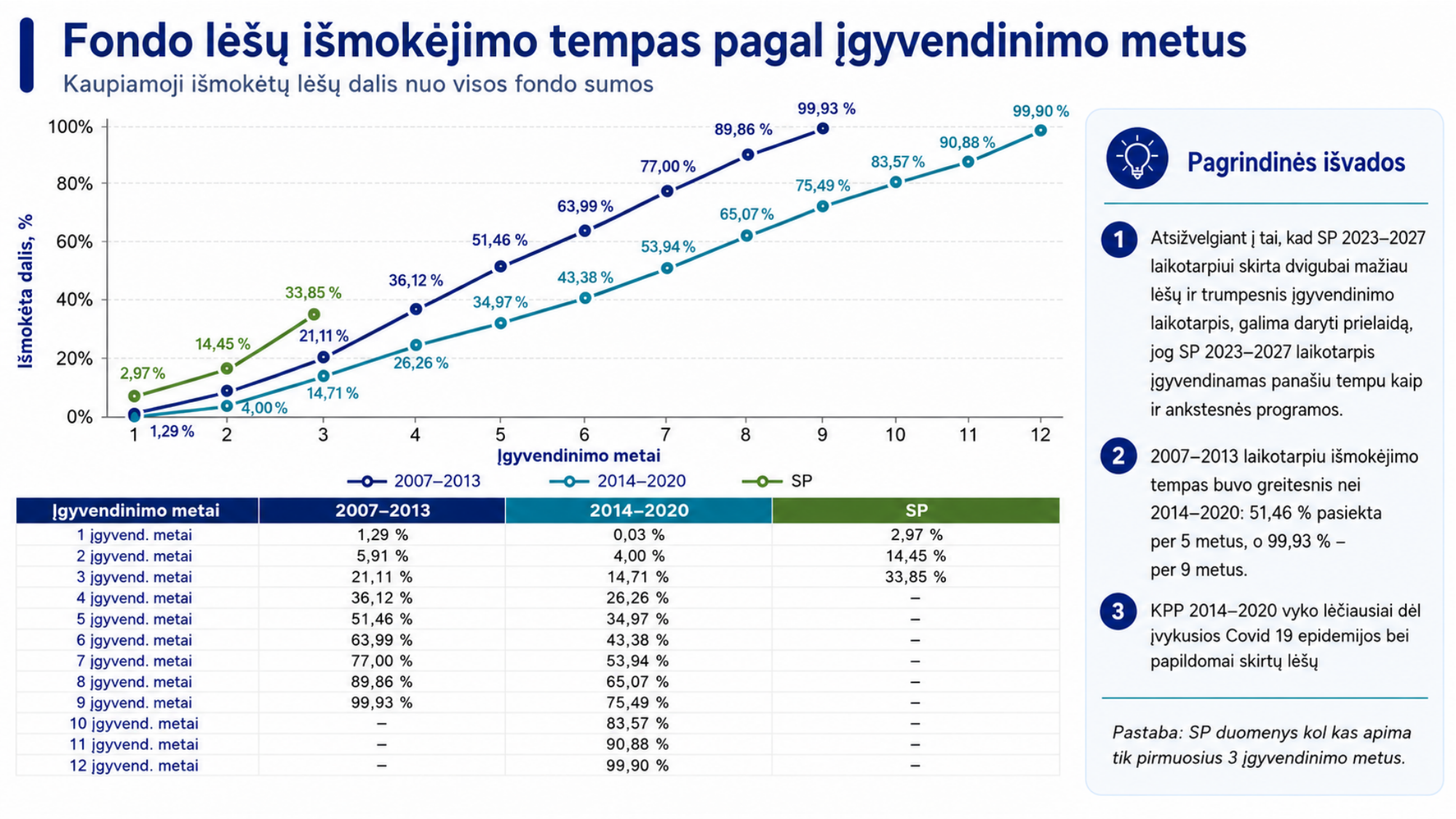
How many implementation years are shown on the x axis? 12 What is the value for the 2007–2013 series in implementation year 5? 51,46 % Do the values of the 2014–2020 series rise or fall as the implementation years increase? rise What is the difference between the 2007–2013 and 2014–2020 values in implementation year 9? 24,44 percentage points Which series has the highest value in implementation year 3? SP What kind of chart is shown on the slide? line chart What is the value for the SP series in implementation year 3? 33,85 % What is the value for the 2014–2020 series in implementation year 12? 99,90 % In implementation year 2, which is larger: the 2007–2013 value or the SP value? SP How many data points does the SP series have on the chart? 3 How many series does the chart legend list? 3 What is the value for the 2007–2013 series in implementation year 7? 77,00 %